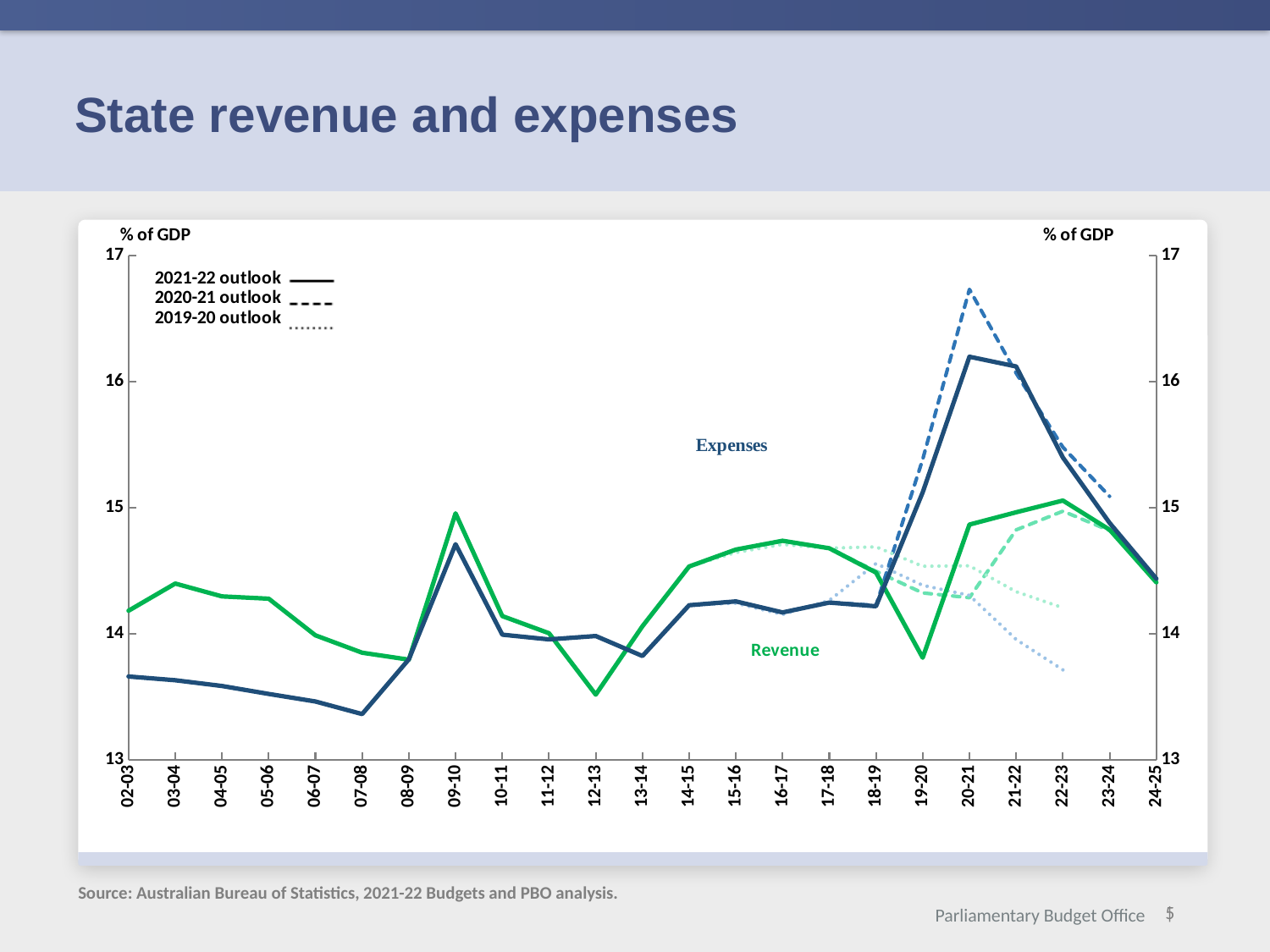
Is the value for Expenses (2021-22 outlook) in 20-21 greater or less than 16? greater In 02-03, which is larger: Revenue or Expenses? Revenue How many outlook series does the legend list? 3 In which year is the solid Revenue line at its lowest value? 12-13 What kind of chart is shown on the slide? Line chart In which year is the solid Expenses line at its lowest value? 07-08 Is the value for Revenue (2021-22 outlook) in 16-17 greater or less than 14? greater Is the value for Expenses (2021-22 outlook) in 07-08 greater or less than 14? less In 20-21, which is larger under the 2021-22 outlook: Expenses or Revenue? Expenses In which year does the solid Expenses line reach its highest value? 20-21 How many financial years are shown along the x axis? 23 Does the solid Expenses line rise or fall from 20-21 to 24-25? Fall